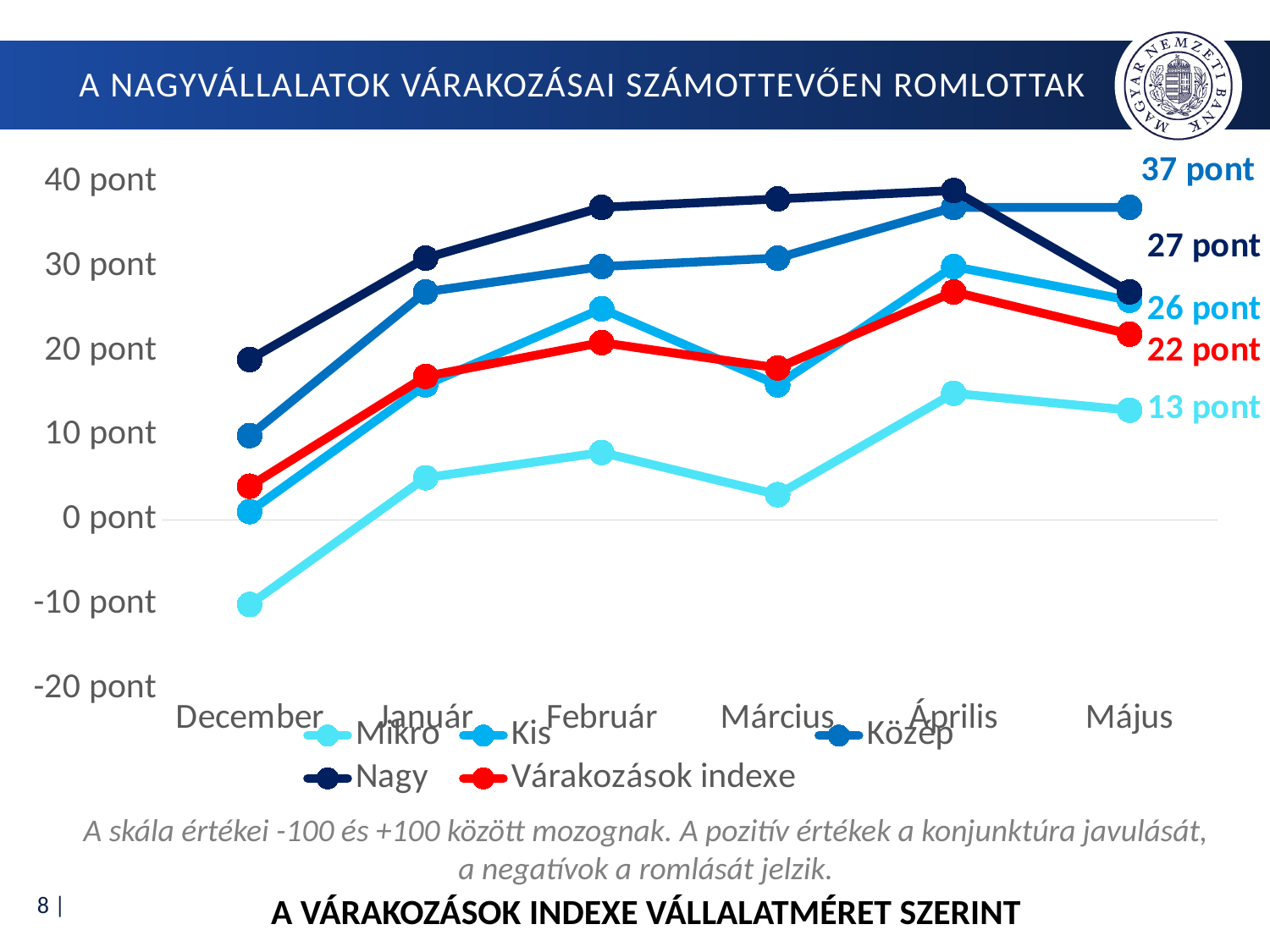
How many months are shown on the x axis? 6 What is the value of the Mikró series in Május? 13 pont How many series does the legend list? 5 Which series has the lowest value in Május? Mikró What is the difference between the Közép and Mikró values in Május? 24 pont Which series has the highest value in Május? Közép What kind of chart is shown on the slide? line chart What is the value of the Nagy series in Május? 27 pont What is the value of the Várakozások indexe series in Május? 22 pont Does the Nagy series rise or fall from Április to Május? fall Is the value of the Mikró series in December greater or less than 0 pont? less What is the value of the Közép series in Május? 37 pont